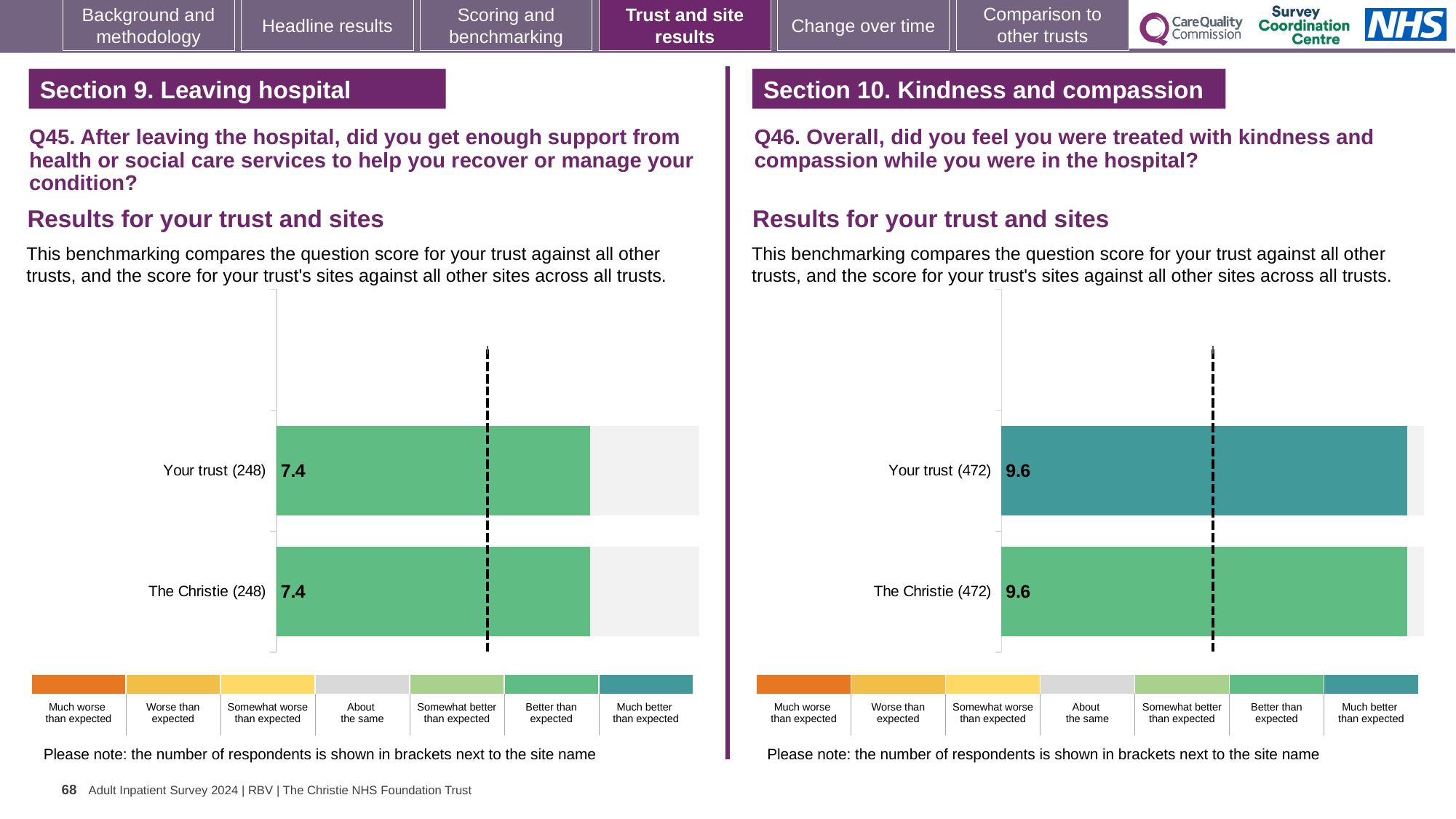
In the Q46 chart on the right, what is the score for Your trust? 9.6 What kind of chart is used for the Q45 results on the left? Bar chart In the Q45 chart on the left, what is the score for Your trust? 7.4 In the Q46 chart on the right, how many respondents are shown in brackets for Your trust? 472 How many bars are plotted in the Q46 chart on the right? 2 In the Q45 chart on the left, how many respondents are shown in brackets for The Christie? 248 How many benchmark categories does the colour key below the Q45 chart on the left list? 7 What is the difference between the Your trust score in the Q46 chart on the right and the Your trust score in the Q45 chart on the left? 2.2 In the Q45 chart on the left, what is the score for The Christie? 7.4 Which is larger: the Your trust score in the Q45 chart on the left or the Your trust score in the Q46 chart on the right? Q46 (9.6) According to the colour key, which benchmark category does the bar colour for Your trust in the Q46 chart on the right correspond to? Much better than expected In the Q46 chart on the right, what is the score for The Christie? 9.6